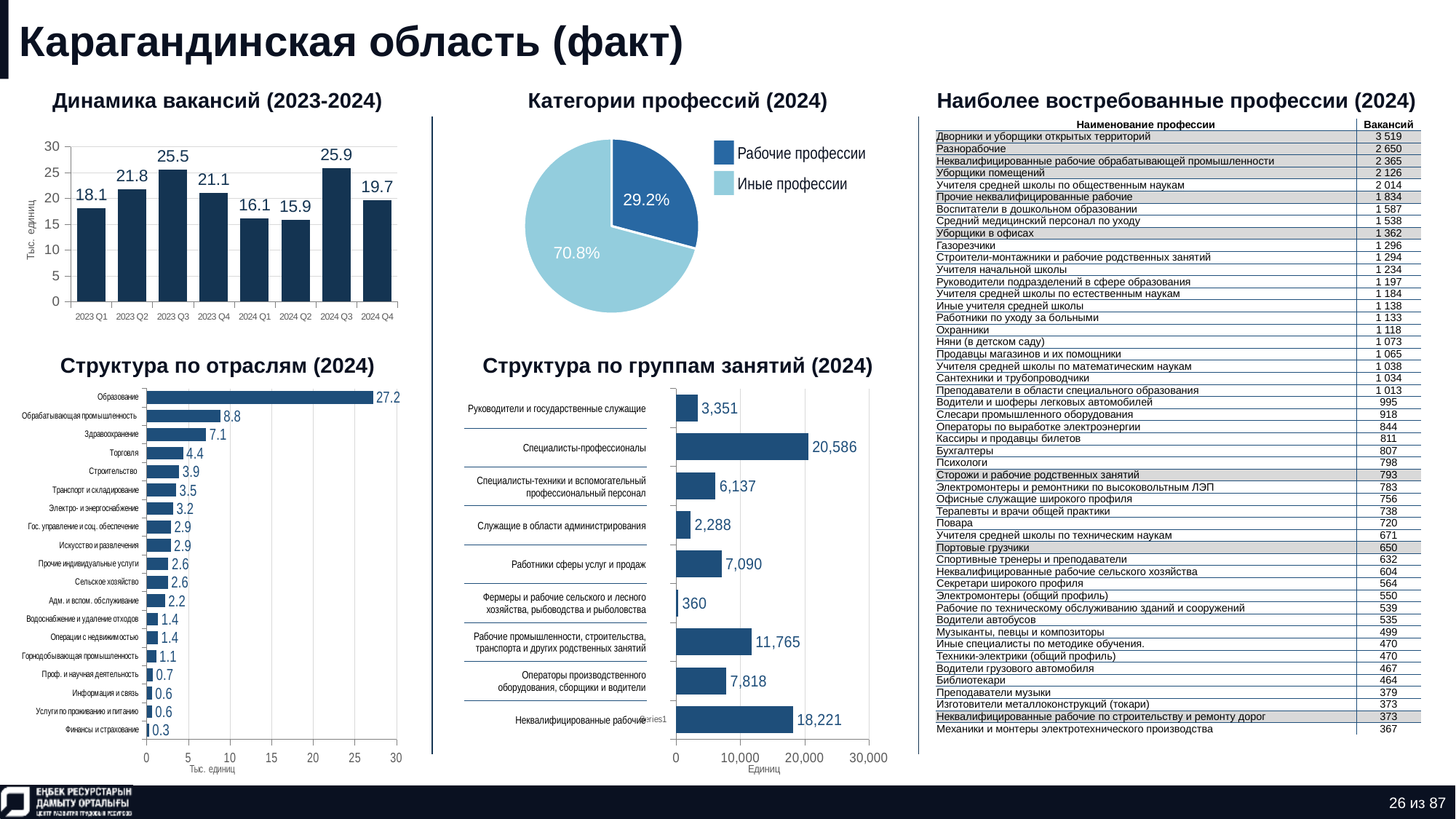
In the 'Структура по отраслям (2024)' chart, which is larger: 'Торговля' or 'Строительство'? Торговля In the 'Динамика вакансий (2023-2024)' chart, which quarter has the highest value? 2024 Q3 In the 'Динамика вакансий (2023-2024)' chart, how many quarters are plotted? 8 In the 'Динамика вакансий (2023-2024)' chart, what is the value for 2023 Q3? 25.5 In the 'Категории профессий (2024)' pie chart, what share is 'Рабочие профессии'? 29.2% In the 'Динамика вакансий (2023-2024)' chart, what is the difference between 2024 Q3 and 2024 Q4? 6.2 In the 'Структура по отраслям (2024)' chart, what is the value for 'Здравоохранение'? 7.1 In the 'Динамика вакансий (2023-2024)' chart, which quarter has the lowest value? 2024 Q2 In the 'Структура по группам занятий (2024)' chart, which category has the lowest value? Фермеры и рабочие сельского и лесного хозяйства, рыбоводства и рыболовства What type of chart is 'Категории профессий (2024)'? Pie chart In the 'Структура по отраслям (2024)' chart, which category has the highest value? Образование In the 'Структура по группам занятий (2024)' chart, what is the value for 'Неквалифицированные рабочие'? 18,221